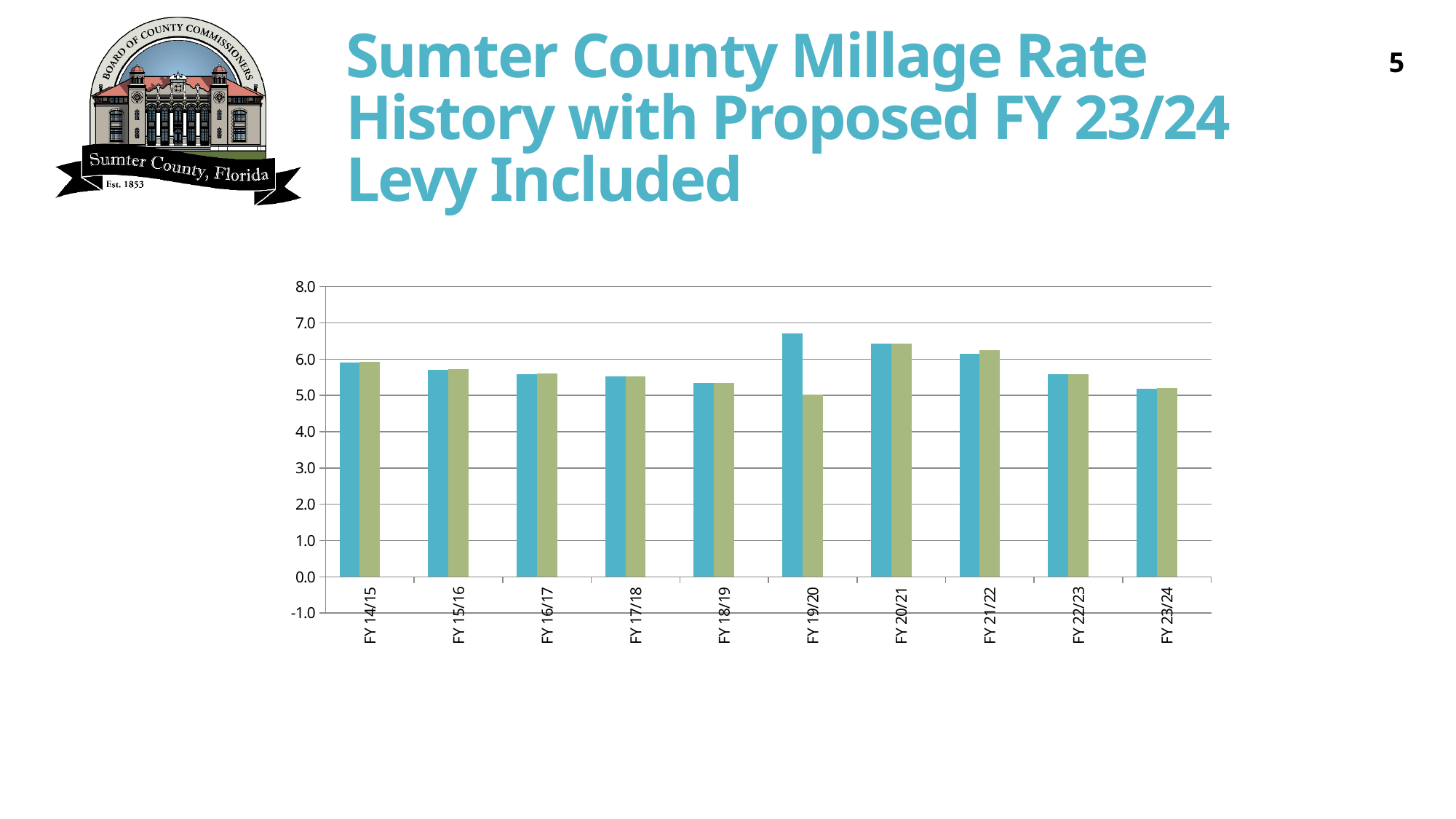
Which fiscal year has the shortest green bar? FY 19/20 For FY 19/20, which bar is taller, the blue bar or the green bar? the blue bar Is the blue bar for FY 20/21 greater or less than 6.0? greater Which fiscal year has the shortest blue bar? FY 23/24 What kind of chart is shown on the slide? bar chart How many fiscal years are shown on the x axis of the chart? 10 Do the blue bars rise or fall from FY 14/15 to FY 18/19? fall Which is taller, the blue bar for FY 14/15 or the blue bar for FY 23/24? FY 14/15 Which fiscal year has the tallest blue bar? FY 19/20 Is the blue bar for FY 23/24 greater or less than 6.0? less Is the blue bar for FY 19/20 greater or less than 6.0? greater